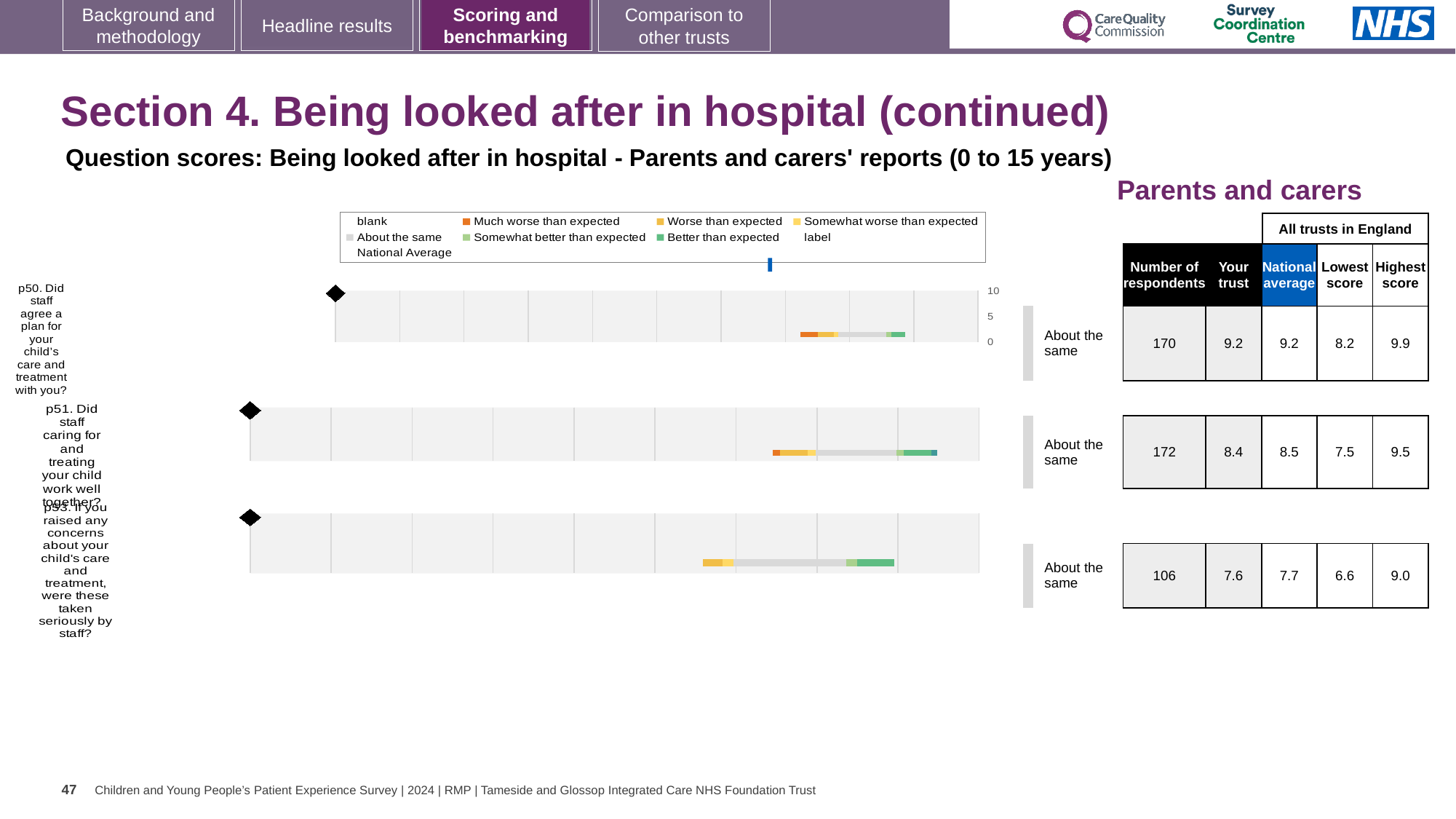
What is the national average score for p51 (Did staff caring for and treating your child work well together?)? 8.5 What benchmark category is shown for p50? About the same Which question has the lowest 'Your trust' score? p53 Which question has the highest 'Your trust' score? p50 What is the highest score across all trusts in England for p53? 9.0 How many respondents answered p53 (If you raised any concerns about your child's care and treatment, were these taken seriously by staff?)? 106 What is the difference between the 'Your trust' scores for p50 and p53? 1.6 For p51, what is the difference between the highest score and the lowest score across all trusts in England? 2.0 For p51, which is larger: the 'Your trust' score or the national average? National average What is the 'Your trust' score for p50 (Did staff agree a plan for your child's care and treatment with you?)? 9.2 What kind of chart is used to show the question scores on this slide? bar chart How many survey questions (p50, p51, p53) are plotted on this slide? 3